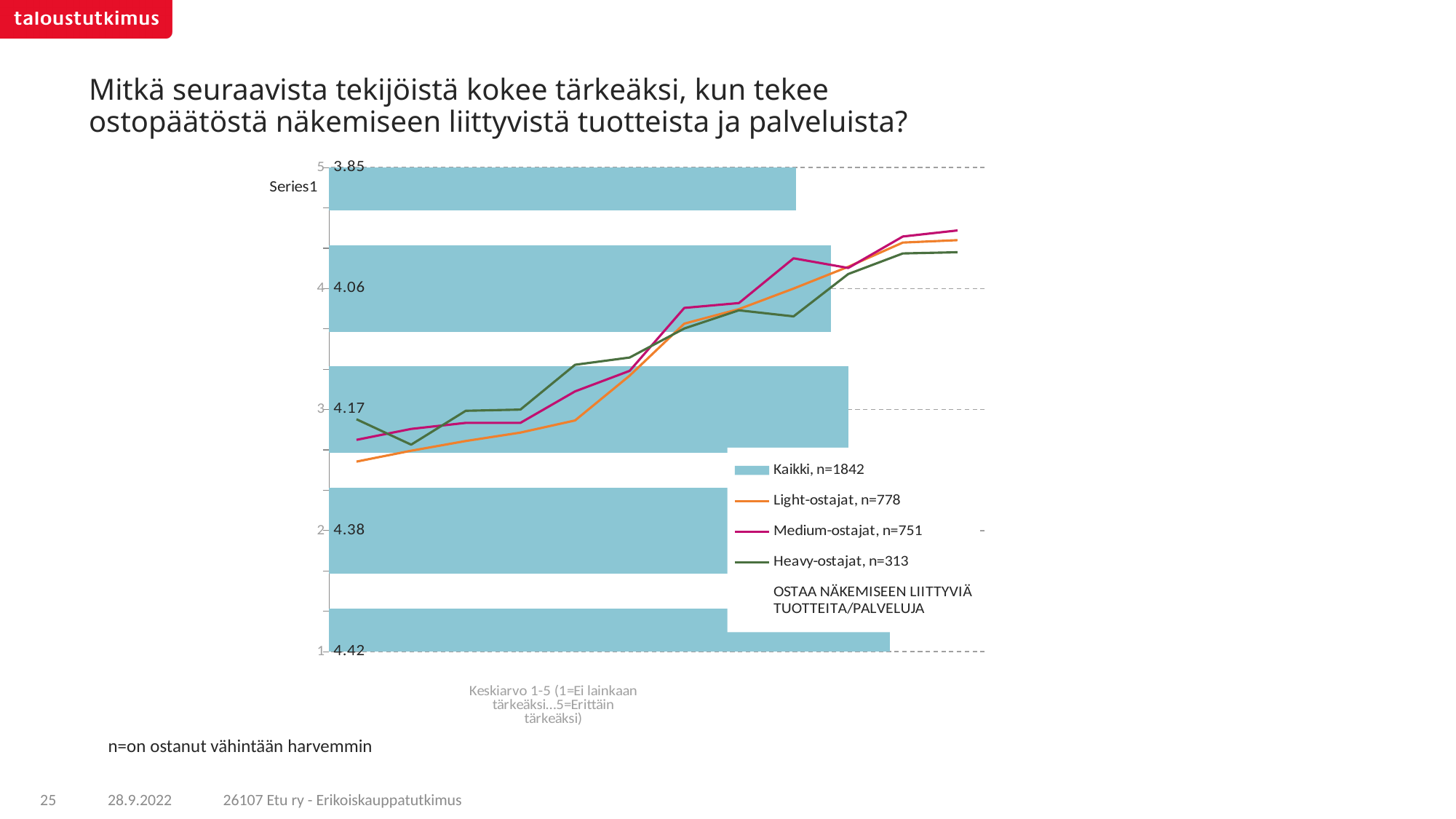
What is the difference between the bar labelled 4.38 and the bar labelled 4.06? 0.32 What is the difference between the highest bar value (4.42) and the lowest bar value (3.85)? 0.57 How many series does the legend list? 5 Which is larger, the bar labelled 4.17 or the bar labelled 4.06? 4.17 What is the lowest value printed on the bars in the chart? 3.85 What is the data label on the bottom bar in the chart? 4.42 Which legend entry is shown as a light blue bar? Kaikki, n=1842 What is the highest value printed on the bars in the chart? 4.42 What is the sample size (n) given in the legend for Heavy-ostajat? 313 How many bars are plotted in the chart? 5 What kind of chart is shown on the slide? A bar chart with overlaid line series What is the data label on the topmost bar in the chart? 3.85